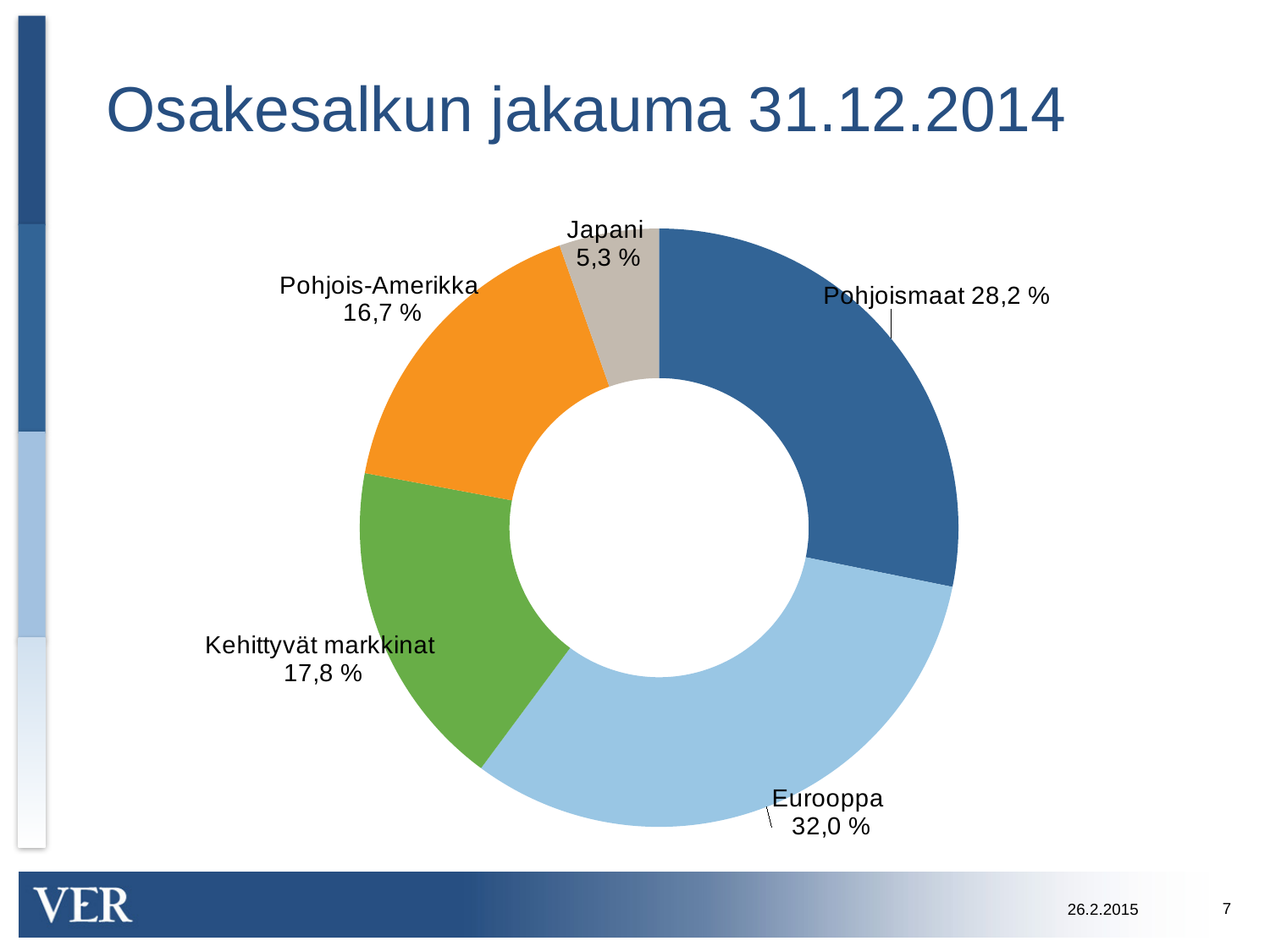
What kind of chart is shown on the slide? Doughnut (pie) chart Which has a larger share, Kehittyvät markkinat or Pohjois-Amerikka? Kehittyvät markkinat Which region has the smallest share of the portfolio? Japani What share of the portfolio is Kehittyvät markkinat? 17,8 % What is the title of the slide? Osakesalkun jakauma 31.12.2014 How many regions are shown in the chart? 5 What is the difference in percentage points between Eurooppa and Pohjoismaat? 3,8 Which region has the largest share of the portfolio? Eurooppa What share of the portfolio is Japani? 5,3 % What share of the portfolio is Pohjois-Amerikka? 16,7 % What share of the portfolio is Pohjoismaat? 28,2 % What share of the portfolio is Eurooppa? 32,0 %